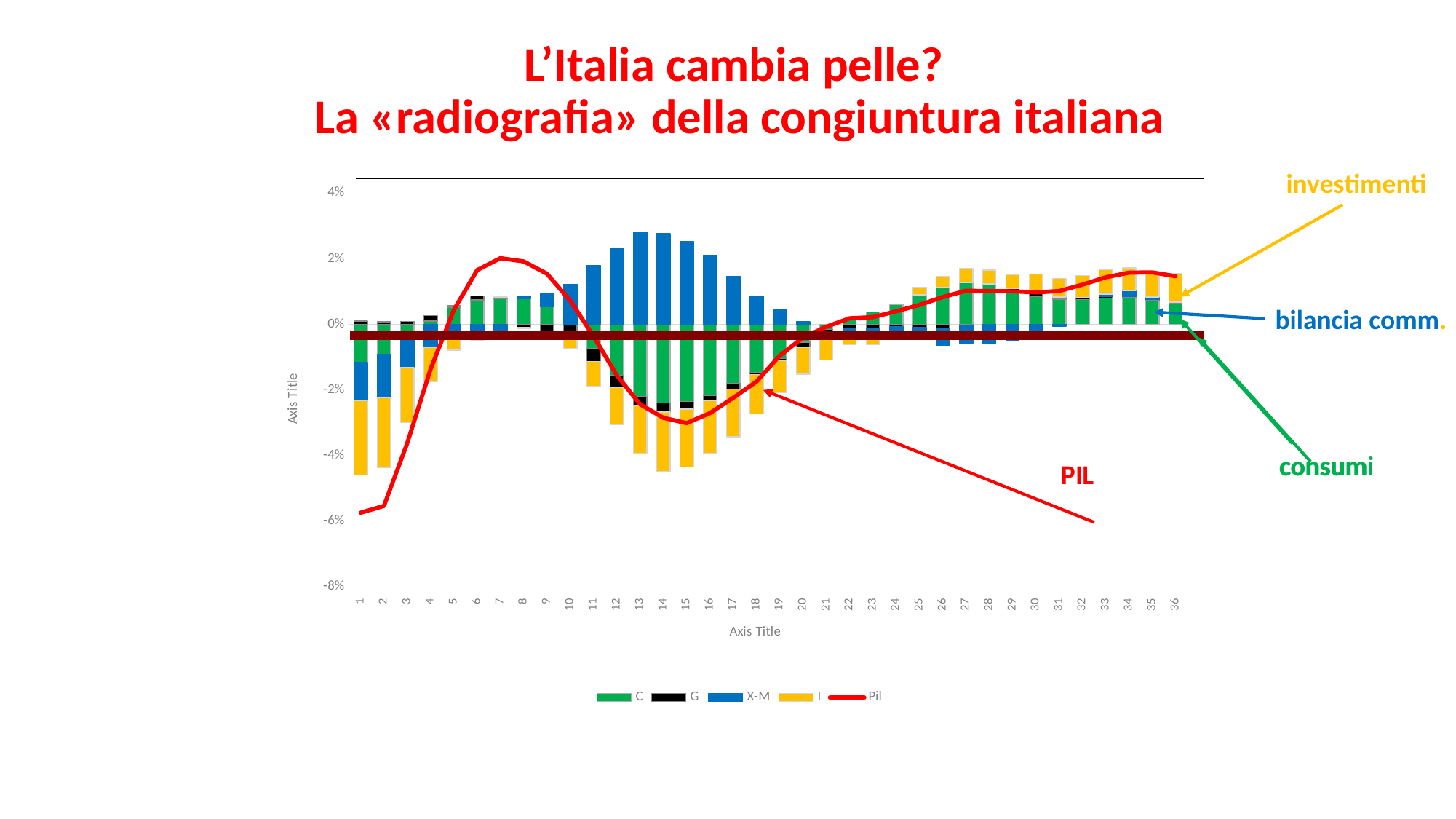
Is the value of the Pil line at category 18 greater or less than 0%? less How many categories are shown on the x axis? 36 How many series does the legend list? 5 Is the value of the Pil line at category 1 greater or less than -4%? less What are the series names listed in the legend? C, G, X-M, I, Pil Does the Pil line rise or fall from category 7 to category 15? fall At which x-axis category does the Pil line reach its lowest value? 1 Which series is shown in yellow in the legend? I Does the Pil line rise or fall from category 1 to category 7? rise Is the value of the Pil line at category 36 greater or less than 0%? greater What kind of chart is shown on the slide? Bar chart with a line